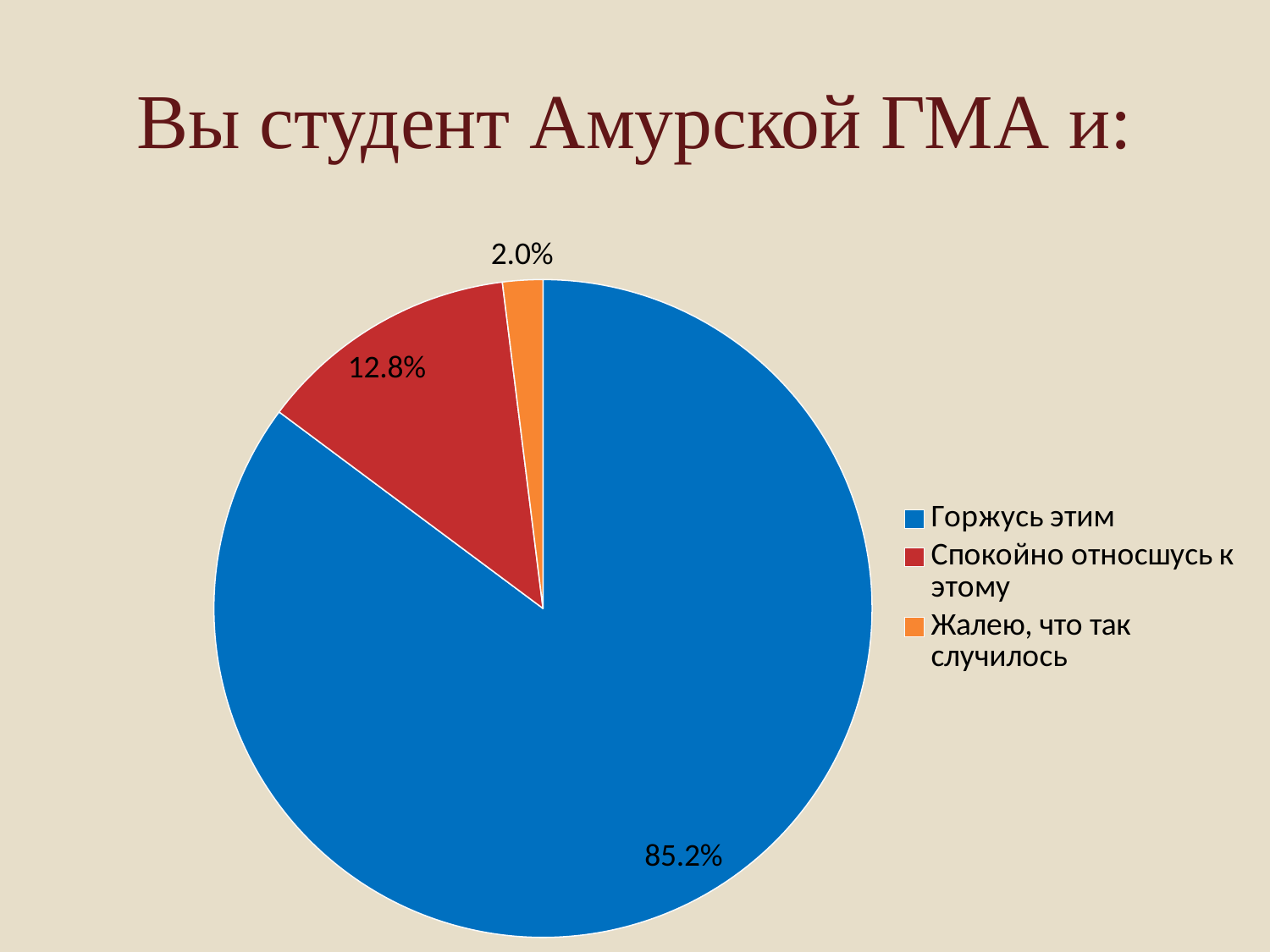
What percentage of respondents answered "Спокойно отношусь к этому"? 12.8% What percentage of respondents answered "Горжусь этим"? 85.2% What colour is the slice for "Жалею, что так случилось"? Orange Which response has the smallest share of the pie? Жалею, что так случилось Which is larger: the share for "Спокойно отношусь к этому" or the share for "Жалею, что так случилось"? Спокойно отношусь к этому Which response has the largest share of the pie? Горжусь этим How many slices does the pie chart have? 3 What percentage of respondents answered "Жалею, что так случилось"? 2.0% What kind of chart is shown on the slide? Pie chart What is the difference in percentage points between "Горжусь этим" and "Спокойно отношусь к этому"? 72.4 What is the title of the slide? Вы студент Амурской ГМА и: What is the difference in percentage points between "Спокойно отношусь к этому" and "Жалею, что так случилось"? 10.8